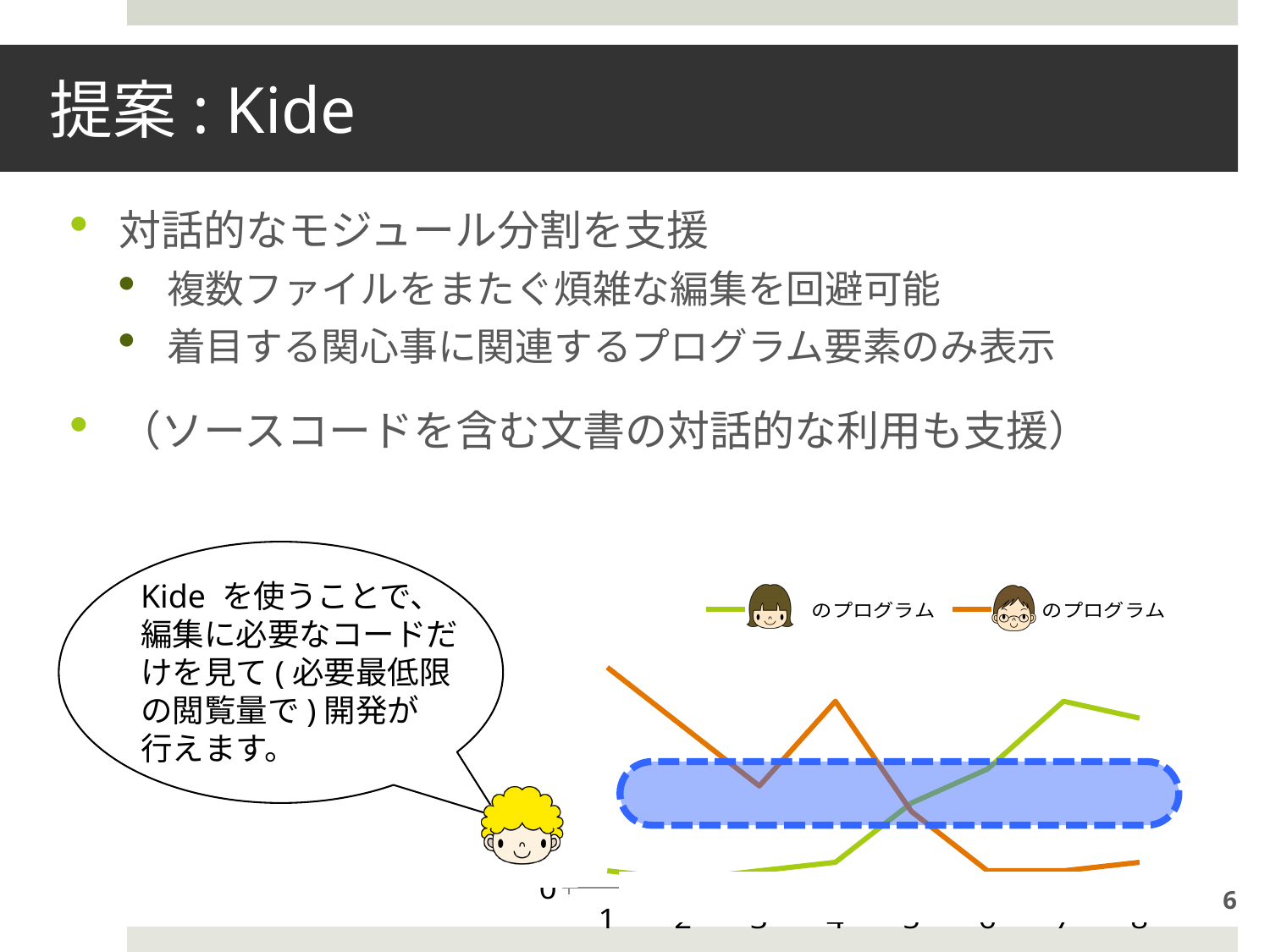
At which x value does the green line reach its highest point? 7 At x = 8, which series has the higher value, the green line or the orange line? the green line What kind of chart is shown at the bottom right of the slide? line chart Does the green line overall rise or fall from x = 1 to x = 8? rise Does the orange line overall rise or fall from x = 1 to x = 8? fall Which series is drawn in green in the chart? the girl's のプログラム At which x value does the orange line reach its highest point? 1 How many points are labelled along the x axis of the chart? 8 How many series does the chart's legend list? 2 Which series is drawn in orange in the chart? the boy's のプログラム What is the only value printed on the chart's y axis? 0 At x = 1, which series has the higher value, the green line or the orange line? the orange line